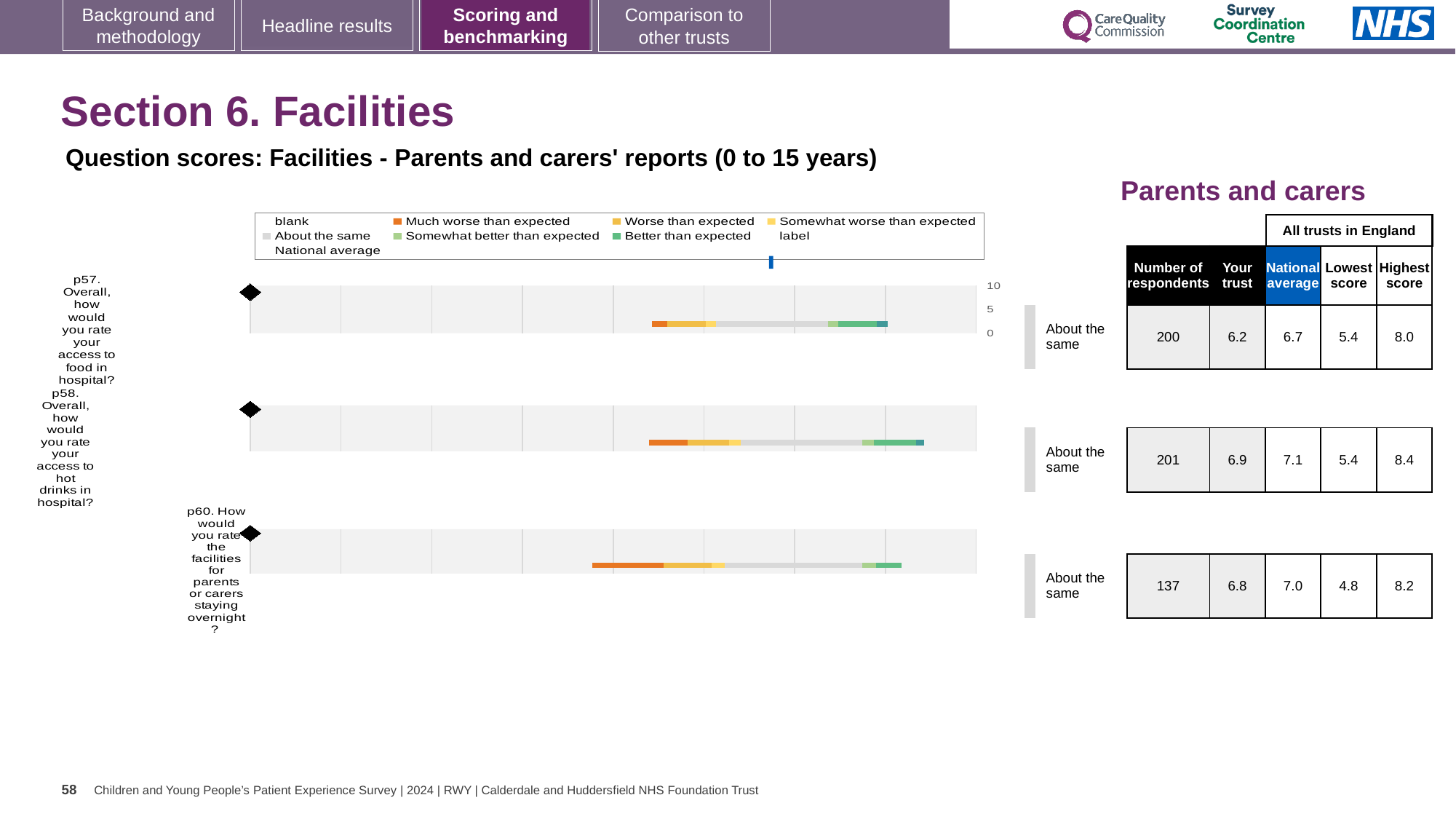
Which question has the highest 'Your trust' score? p58 (access to hot drinks in hospital) How many respondents answered p60 (How would you rate the facilities for parents or carers staying overnight?)? 137 Which question has the lowest 'Lowest score' across all trusts in England? p60 (facilities for parents or carers staying overnight) How many questions are charted on this slide? 3 Is the 'Your trust' score for p58 higher or lower than the national average? lower What is the difference between the national average and the 'Your trust' score for p57? 0.5 What is the highest score across all trusts in England for p58? 8.4 What kind of chart is used to show the question scores? bar chart What is the 'Your trust' score for p57 (Overall, how would you rate your access to food in hospital?)? 6.2 What is the national average score for p58 (Overall, how would you rate your access to hot drinks in hospital?)? 7.1 What benchmark category is shown for all three questions? About the same Is the 'Your trust' score for p60 greater or less than 5? greater